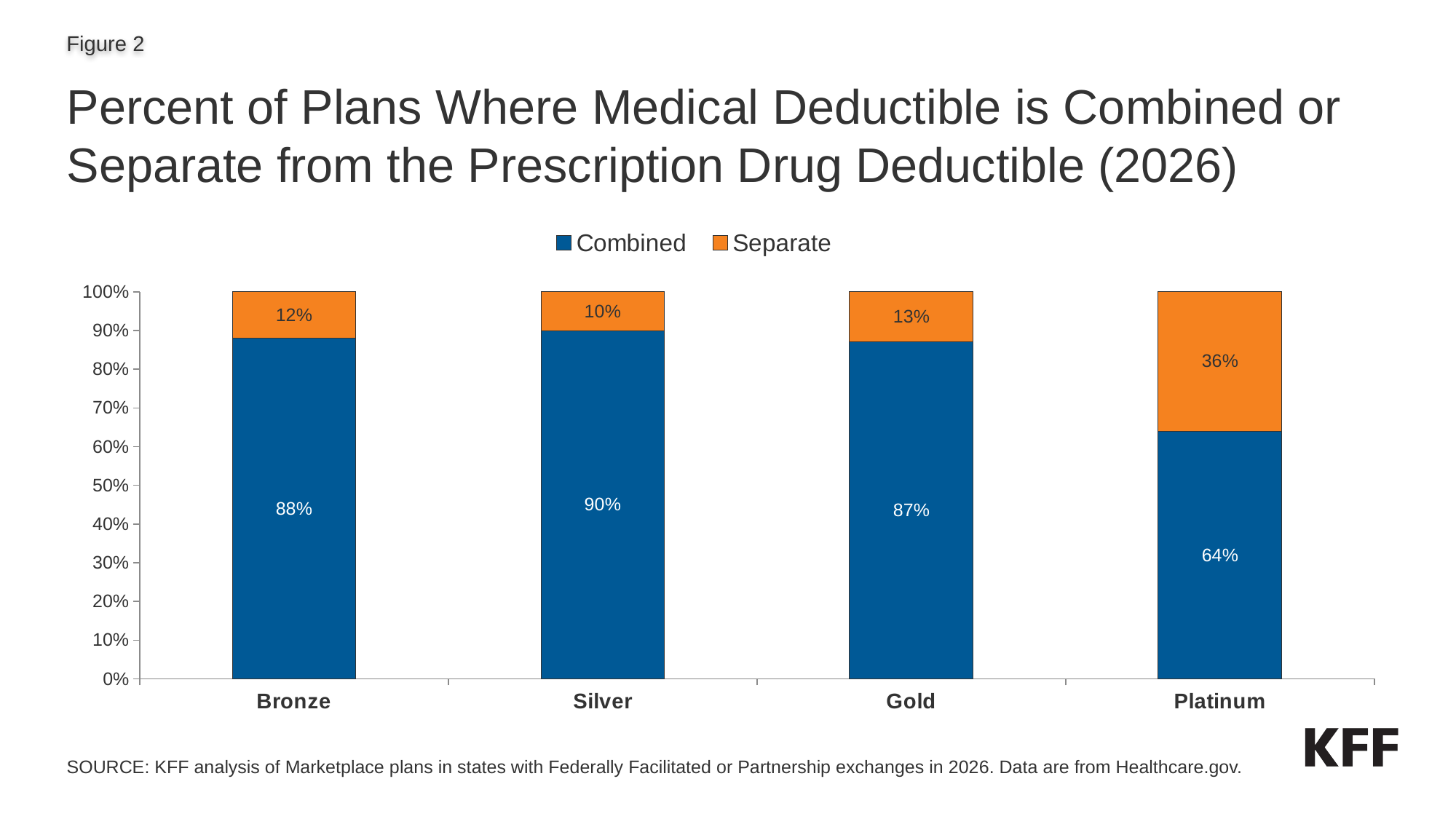
What percent of Gold plans have a Combined deductible? 87% What percent of Bronze plans have a Combined deductible? 88% How many series does the legend list? 2 What kind of chart is shown on the slide? Stacked bar chart Which metal tier has the lowest Separate percentage? Silver Which colour represents the Separate series in the chart? Orange What is the difference between the Separate percentage for Platinum and for Bronze? 24% What percent of Platinum plans have a Separate deductible? 36% Is the Combined percentage larger for Silver or for Gold? Silver How many metal tiers are shown on the x axis? 4 Which metal tier has the lowest Combined percentage? Platinum Which metal tier has the highest Combined percentage? Silver